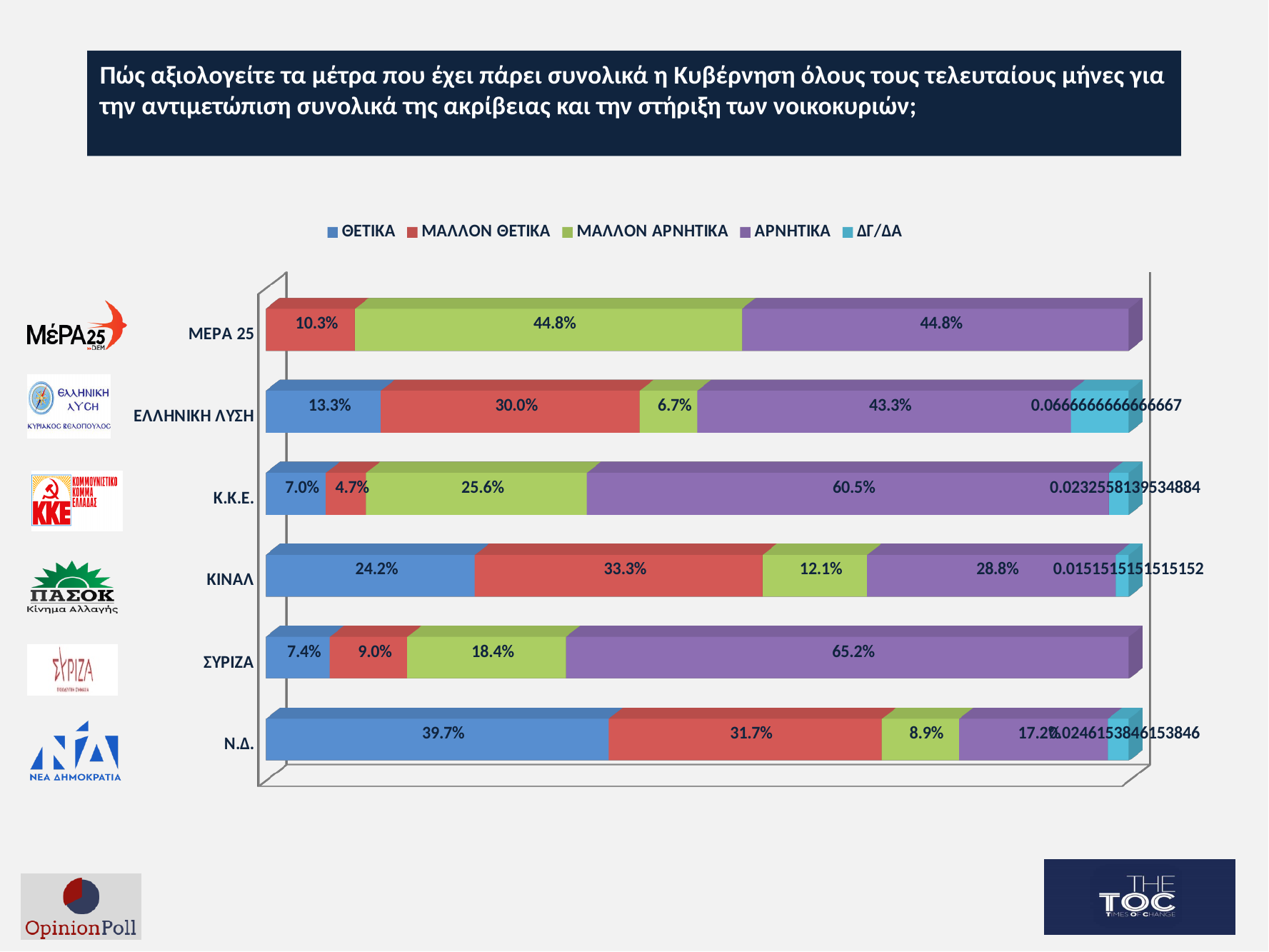
What is the difference between the ΘΕΤΙΚΑ value for Ν.Δ. and the ΘΕΤΙΚΑ value for ΚΙΝΑΛ? 15.5 percentage points What is the ΘΕΤΙΚΑ value for Ν.Δ.? 39.7% How many parties are shown on the chart? 6 Which party has the highest ΑΡΝΗΤΙΚΑ value? ΣΥΡΙΖΑ Which party has the lowest ΜΑΛΛΟΝ ΘΕΤΙΚΑ value? Κ.Κ.Ε. What kind of chart is shown on the slide? Stacked bar chart How many series does the legend list? 5 Which is larger: the ΜΑΛΛΟΝ ΘΕΤΙΚΑ value for ΚΙΝΑΛ or for Ν.Δ.? ΚΙΝΑΛ What is the ΜΑΛΛΟΝ ΑΡΝΗΤΙΚΑ value for ΜΕΡΑ 25? 44.8% What is the ΑΡΝΗΤΙΚΑ value for ΣΥΡΙΖΑ? 65.2% What is the ΜΑΛΛΟΝ ΘΕΤΙΚΑ value for ΕΛΛΗΝΙΚΗ ΛΥΣΗ? 30.0% Which party has the highest ΘΕΤΙΚΑ value? Ν.Δ.